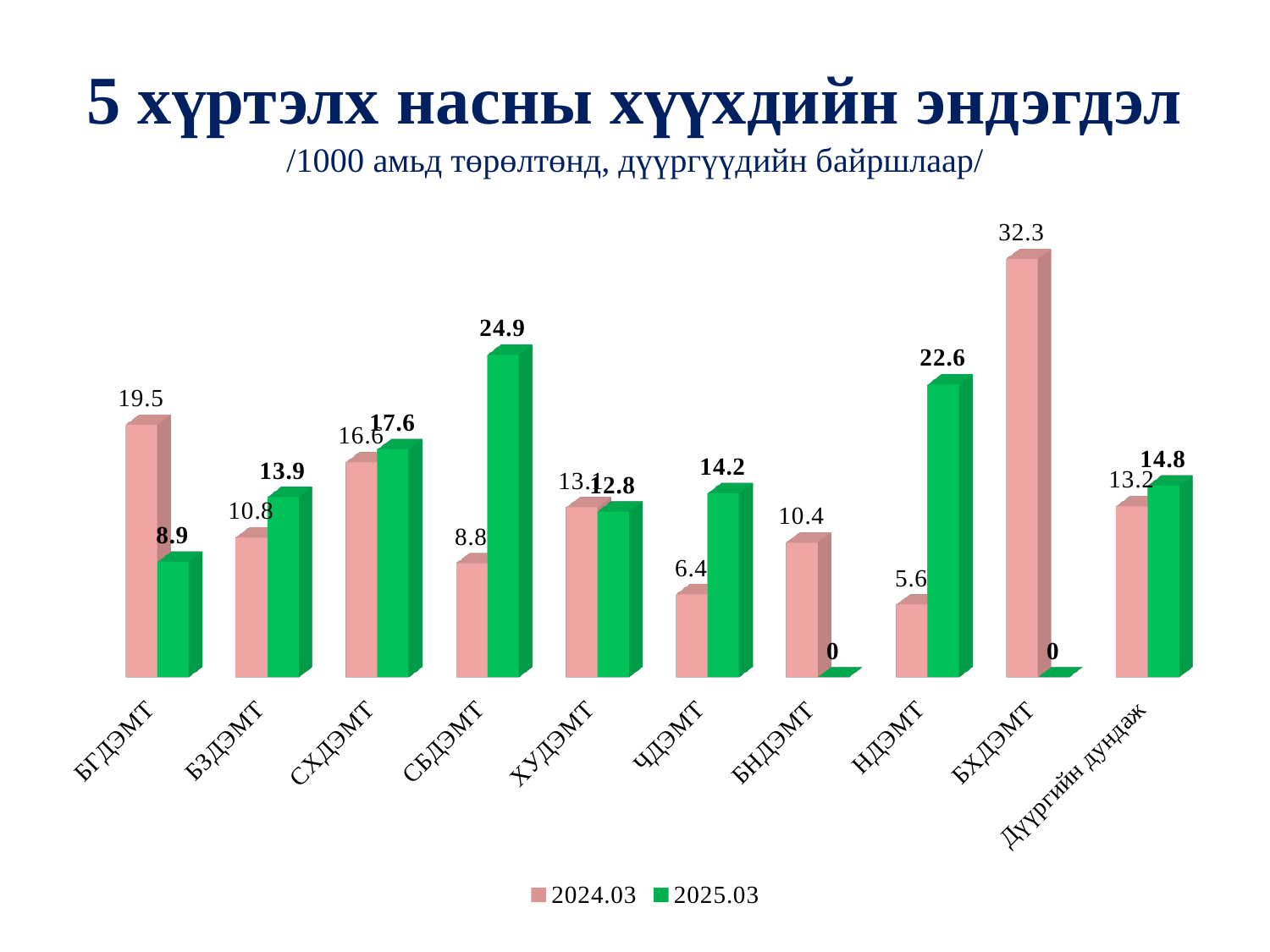
Which category has the highest 2025.03 value? СБДЭМТ What is the 2024.03 value for БХДЭМТ? 32.3 Which is larger for БГДЭМТ, the 2024.03 value or the 2025.03 value? 2024.03 What is the difference between the 2025.03 and 2024.03 values for СБДЭМТ? 16.1 Which category has the highest 2024.03 value? БХДЭМТ Which category has the lowest 2024.03 value? НДЭМТ What is the 2025.03 value for Дүүргийн дундаж? 14.8 What kind of chart is shown on the slide? Bar chart How many categories are shown on the x axis? 10 How many series does the legend list? 2 What is the 2024.03 value for НДЭМТ? 5.6 What is the 2025.03 value for СБДЭМТ? 24.9